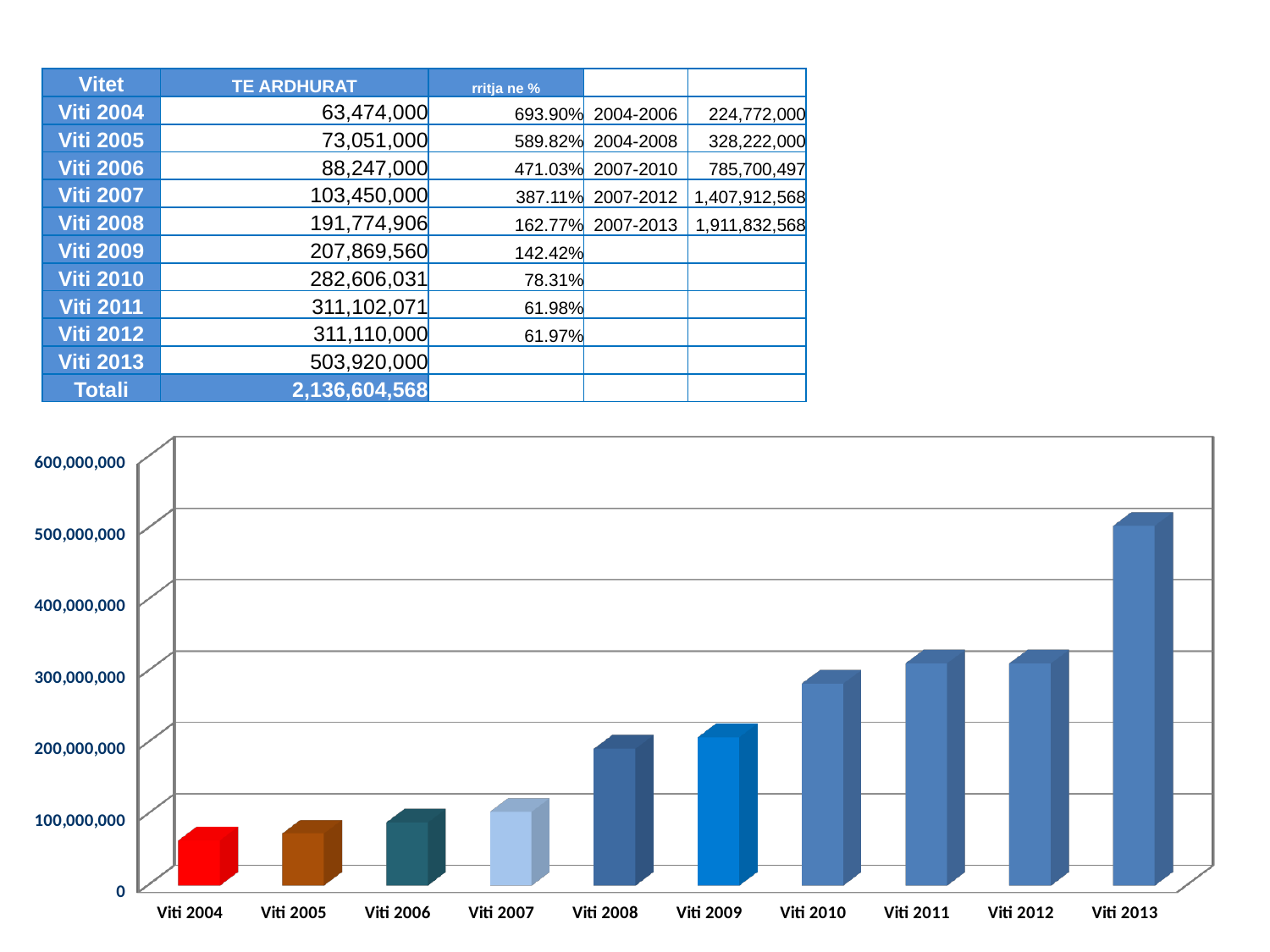
How many years (categories) are plotted on the x axis of the chart? 10 Which bar is taller, Viti 2010 or Viti 2009? Viti 2010 Is the value for Viti 2010 in the chart greater or less than 200,000,000? greater According to the table, what is the TE ARDHURAT value for Viti 2008? 191,774,906 What kind of chart is shown on the slide? bar chart Is the value for Viti 2013 in the chart greater or less than 400,000,000? greater Which year has the shortest bar in the chart? Viti 2004 Is the value for Viti 2007 in the chart greater or less than 200,000,000? less Do the bar values generally rise or fall from Viti 2004 to Viti 2013? rise According to the table, what is the Totali value of TE ARDHURAT? 2,136,604,568 What colour is the bar for Viti 2004 in the chart? red Which year has the tallest bar in the chart? Viti 2013